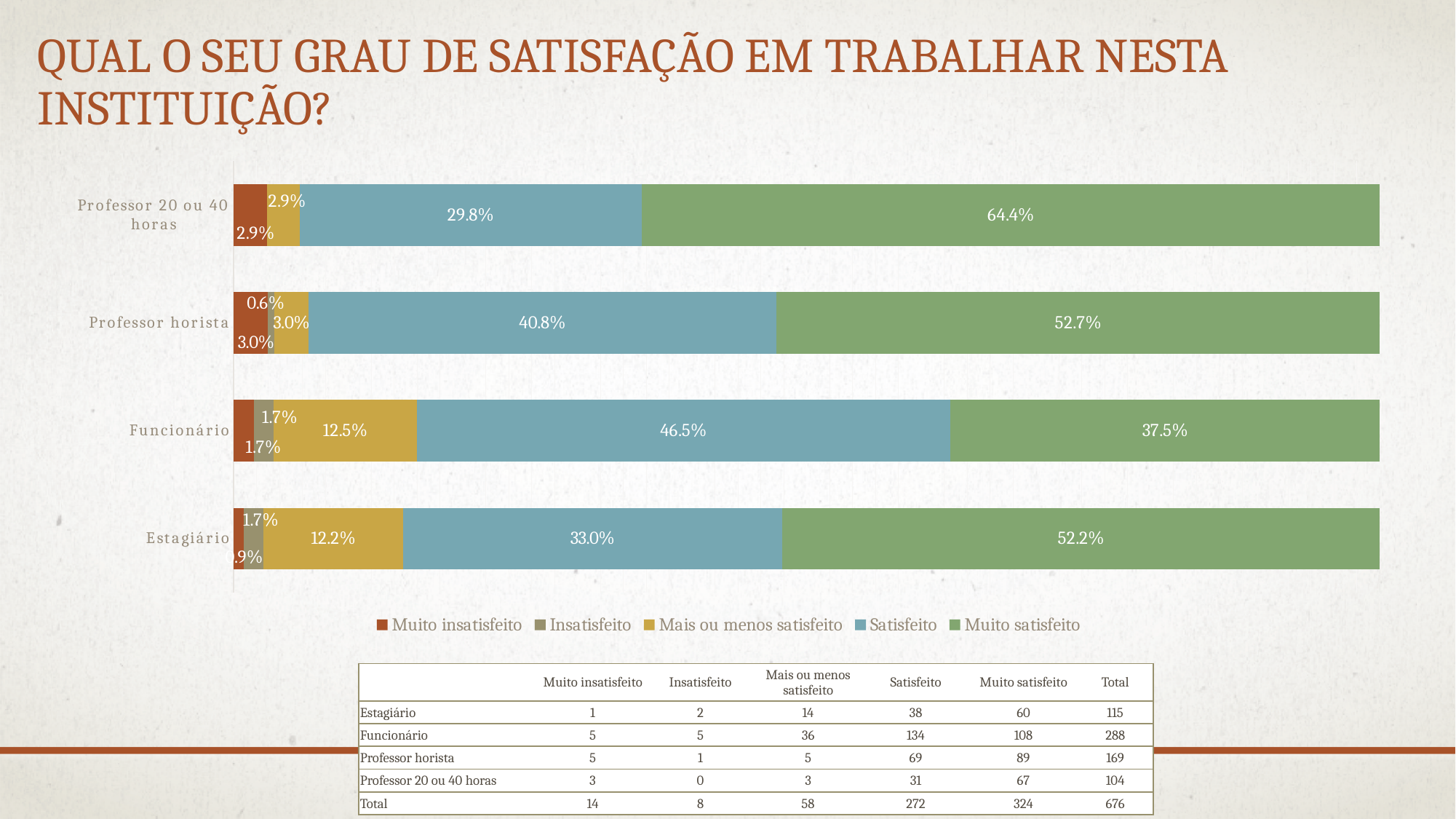
Which has a larger 'Satisfeito' value, 'Professor horista' or 'Estagiário'? Professor horista What colour represents 'Muito satisfeito' in the chart? Green How many categories (bars) are shown in the chart? 4 Which category has the lowest 'Muito satisfeito' percentage? Funcionário What is the 'Mais ou menos satisfeito' value for 'Estagiário'? 12.2% What percentage of 'Professor 20 ou 40 horas' respondents are 'Muito satisfeito'? 64.4% What kind of chart is shown on the slide? Stacked bar chart What is the 'Satisfeito' value for 'Funcionário'? 46.5% What is the 'Insatisfeito' value for 'Professor horista'? 0.6% How many series does the legend list? 5 Which category has the highest 'Muito satisfeito' percentage? Professor 20 ou 40 horas How much larger is the 'Satisfeito' value for 'Funcionário' than for 'Professor 20 ou 40 horas'? 16.7 percentage points